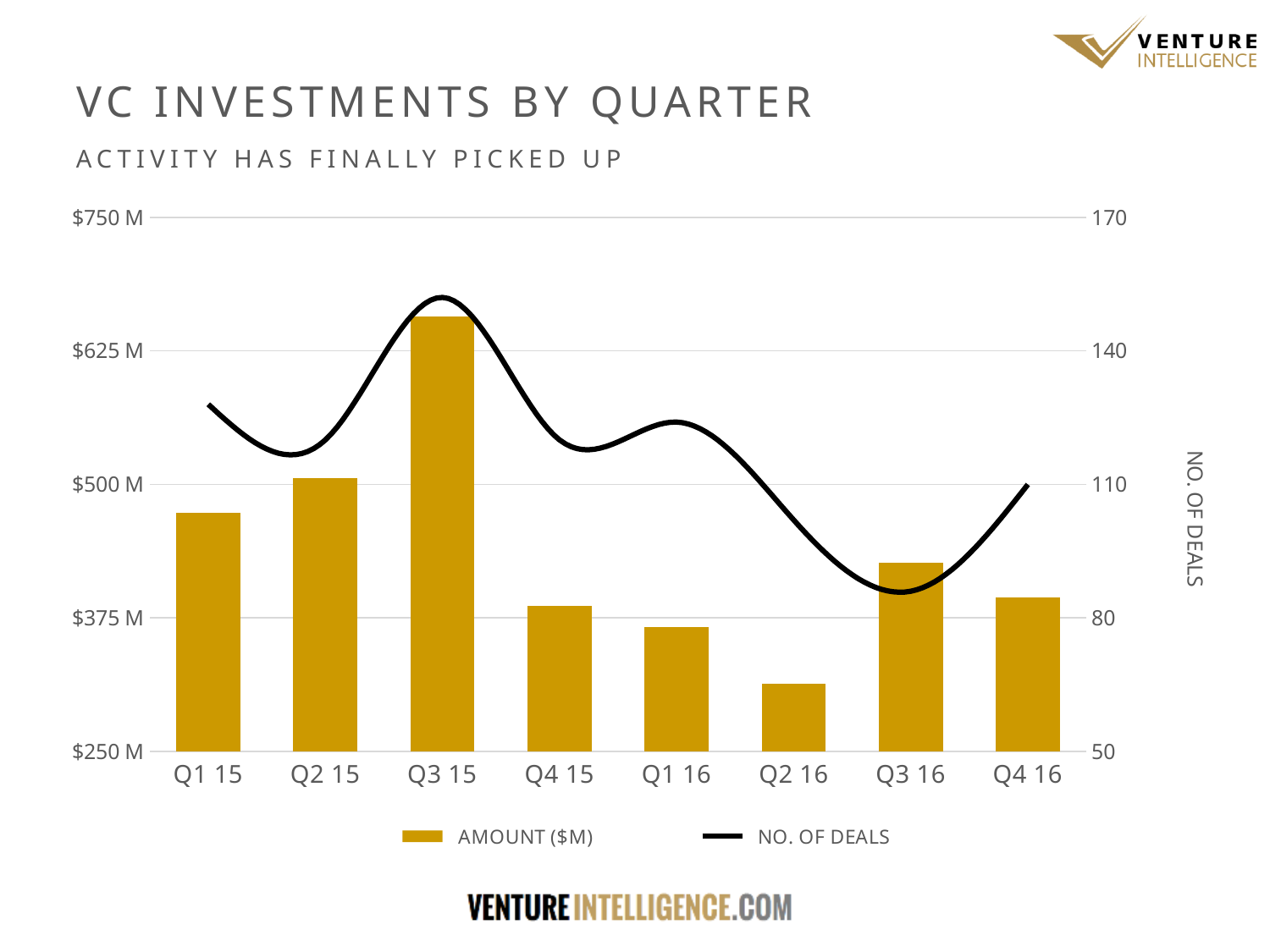
Which quarter has the lowest number of deals? Q3 16 How many series does the legend list? 2 Which quarter has a larger investment amount, Q1 15 or Q1 16? Q1 15 Is the investment amount for Q3 15 greater or less than $625 M? greater What type of chart is shown on the slide? Combined bar and line chart What is the title of the chart on the slide? VC Investments by Quarter Is the number of deals in Q3 16 greater or less than 110? less How many quarters are shown on the x axis? 8 Which quarter has the highest investment amount? Q3 15 Is the investment amount for Q2 16 greater or less than $375 M? less Which quarter has the highest number of deals? Q3 15 Which quarter has the lowest investment amount? Q2 16